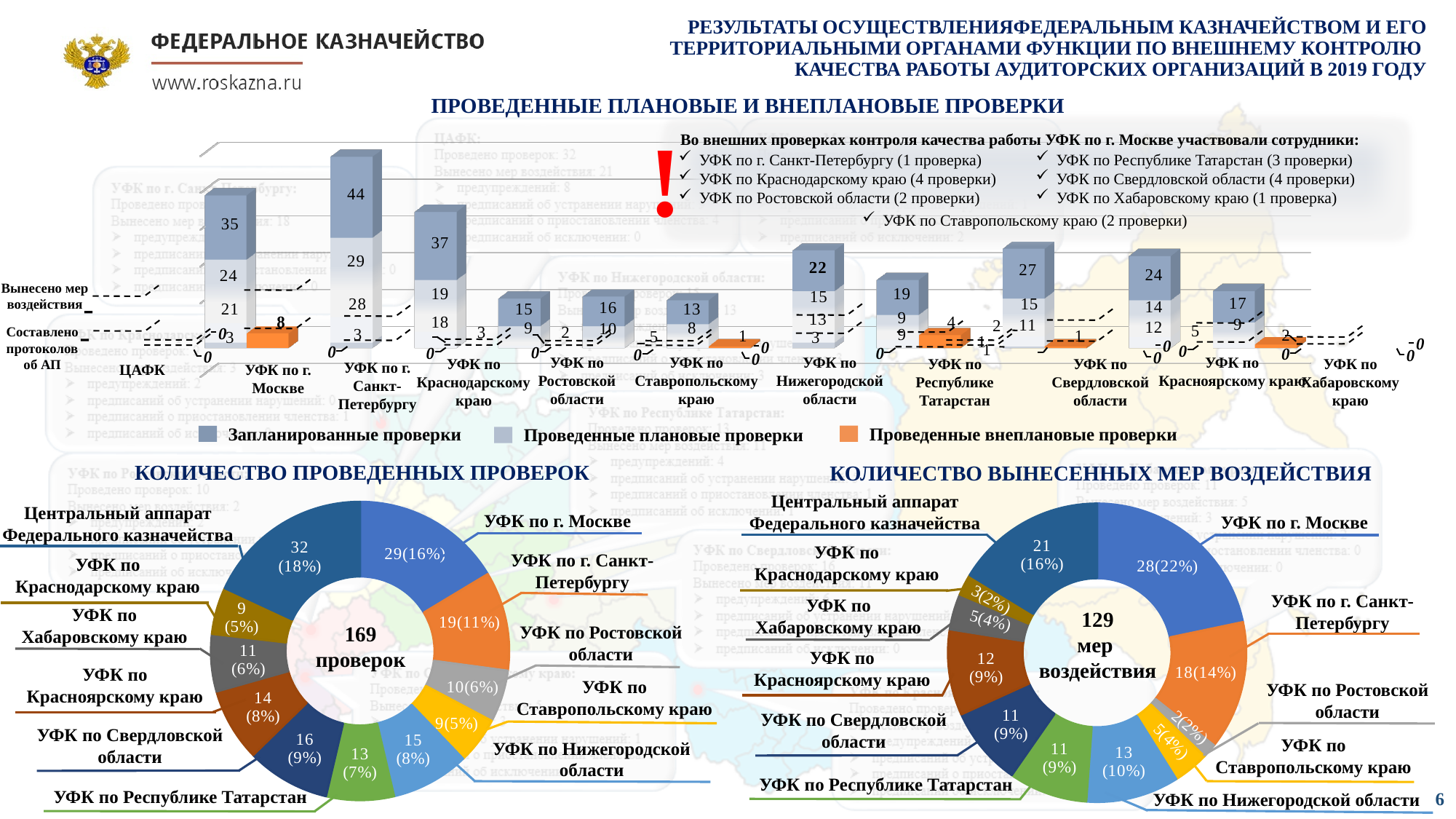
In the chart 'КОЛИЧЕСТВО ВЫНЕСЕННЫХ МЕР ВОЗДЕЙСТВИЯ', which category has the largest slice? УФК по г. Москве In the chart 'КОЛИЧЕСТВО ПРОВЕДЕННЫХ ПРОВЕРОК', what value is shown for УФК по г. Москве? 29(16%) In the chart 'КОЛИЧЕСТВО ВЫНЕСЕННЫХ МЕР ВОЗДЕЙСТВИЯ', which category has the smallest slice? УФК по Ростовской области In the chart 'КОЛИЧЕСТВО ВЫНЕСЕННЫХ МЕР ВОЗДЕЙСТВИЯ', which is larger: the value for УФК по г. Санкт-Петербургу or for Центральный аппарат Федерального казначейства? Центральный аппарат Федерального казначейства In the top chart 'ПРОВЕДЕННЫЕ ПЛАНОВЫЕ И ВНЕПЛАНОВЫЕ ПРОВЕРКИ', how many series does the legend list? 3 In the chart 'КОЛИЧЕСТВО ПРОВЕДЕННЫХ ПРОВЕРОК', what share of the total is УФК по Свердловской области? 9% What kind of chart is the top chart 'ПРОВЕДЕННЫЕ ПЛАНОВЫЕ И ВНЕПЛАНОВЫЕ ПРОВЕРКИ'? bar chart In the chart 'КОЛИЧЕСТВО ПРОВЕДЕННЫХ ПРОВЕРОК', which category has the largest slice? Центральный аппарат Федерального казначейства In the chart 'КОЛИЧЕСТВО ВЫНЕСЕННЫХ МЕР ВОЗДЕЙСТВИЯ', what value is shown for УФК по Нижегородской области? 13(10%) In the chart 'КОЛИЧЕСТВО ПРОВЕДЕННЫХ ПРОВЕРОК', what total number is printed in the centre of the donut? 169 проверок In the chart 'КОЛИЧЕСТВО ВЫНЕСЕННЫХ МЕР ВОЗДЕЙСТВИЯ', how many categories are shown? 11 In the chart 'КОЛИЧЕСТВО ПРОВЕДЕННЫХ ПРОВЕРОК', what is the difference between the values for УФК по г. Санкт-Петербургу and УФК по Ростовской области? 9